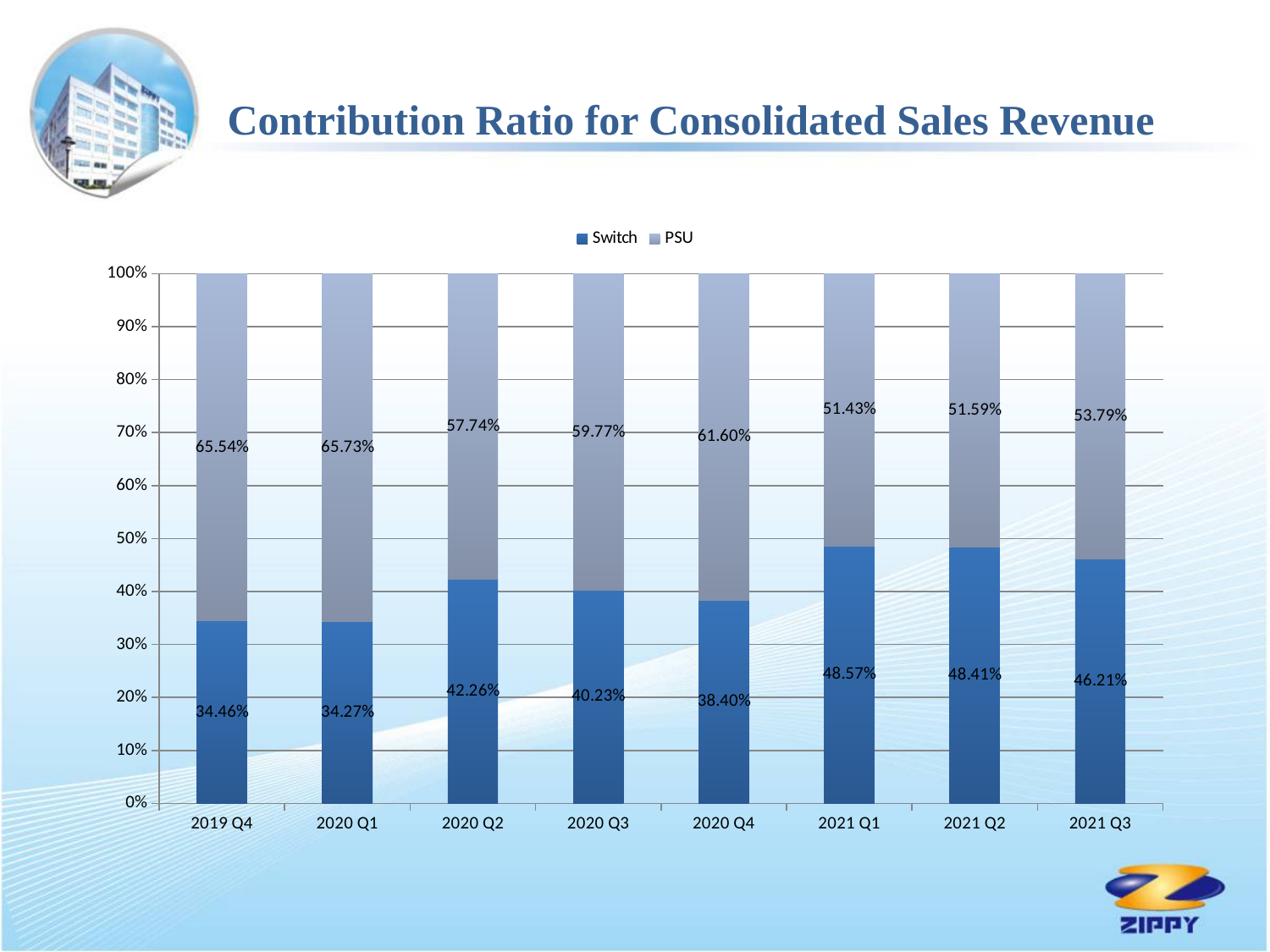
What is the title of the chart on the slide? Contribution Ratio for Consolidated Sales Revenue Which is larger in 2021 Q2, the Switch ratio or the PSU ratio? PSU What is the PSU contribution ratio for 2020 Q4? 61.60% How many quarters are shown on the x axis? 8 What is the Switch contribution ratio for 2020 Q2? 42.26% In which quarter is the PSU contribution ratio lowest? 2021 Q1 What is the PSU contribution ratio for 2021 Q3? 53.79% How many series does the legend list? 2 In which quarter is the Switch contribution ratio highest? 2021 Q1 What is the difference between the PSU and Switch contribution ratios in 2020 Q3? 19.54% What kind of chart is shown on the slide? Stacked bar chart What is the Switch contribution ratio for 2019 Q4? 34.46%